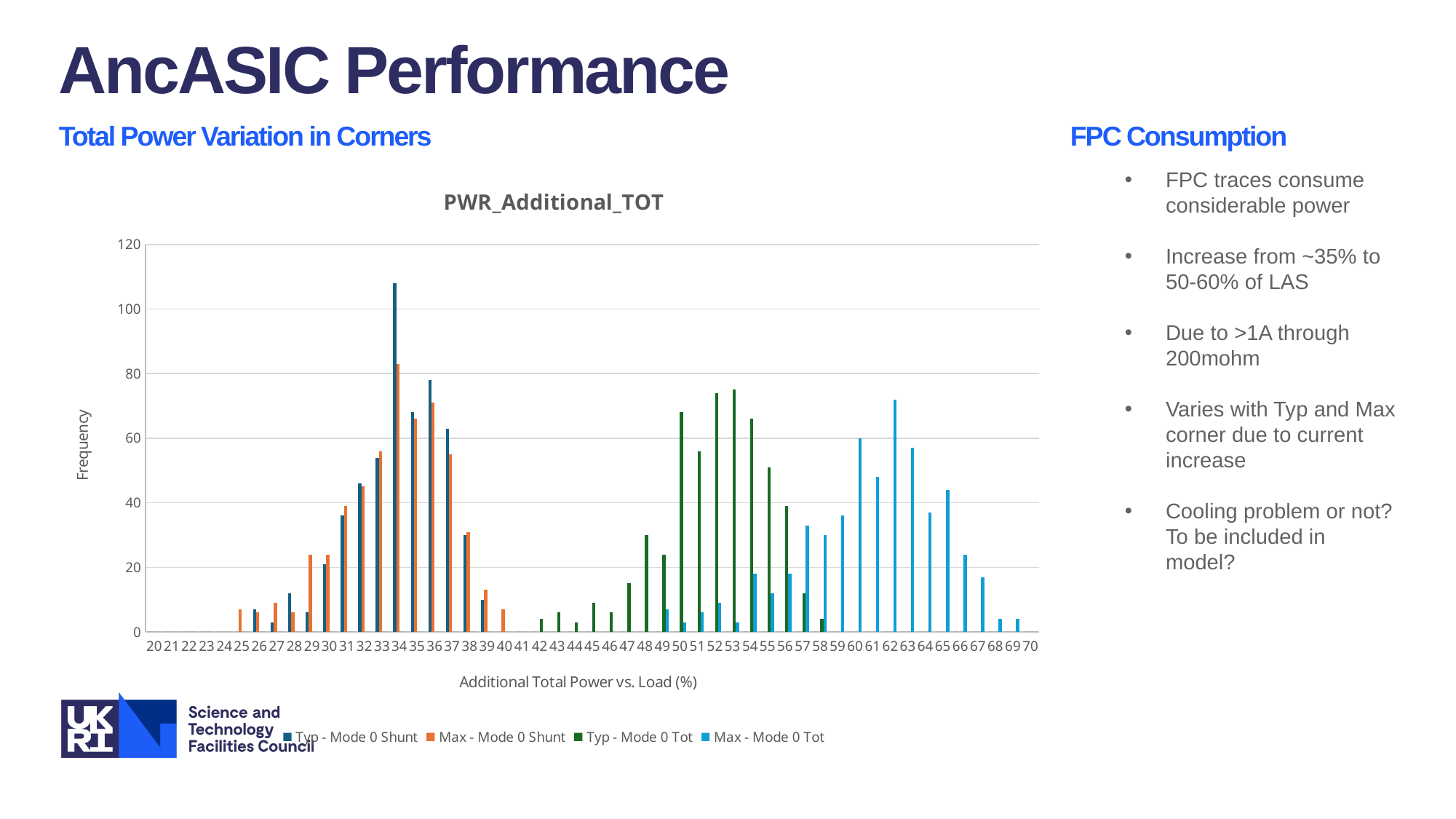
At x-axis value 34, which series has the higher frequency: Typ - Mode 0 Shunt or Max - Mode 0 Shunt? Typ - Mode 0 Shunt At which x-axis value does the Typ - Mode 0 Shunt series reach its highest frequency? 34 What kind of chart is shown on the slide? bar chart At which x-axis value does the Max - Mode 0 Shunt series reach its highest frequency? 34 How many series does the legend of the chart list? 4 What is the label of the x axis of the chart? Additional Total Power vs. Load (%) What is the title of the chart? PWR_Additional_TOT Which is larger: the peak frequency of Typ - Mode 0 Shunt (at 34) or the peak frequency of Max - Mode 0 Tot (at 62)? Typ - Mode 0 Shunt Is the frequency for Typ - Mode 0 Tot at 42 greater or less than 20? less Is the frequency for Typ - Mode 0 Shunt at 34 greater or less than 100? greater At which x-axis value does the Max - Mode 0 Tot series reach its highest frequency? 62 Is the frequency for Max - Mode 0 Tot at 62 greater or less than 60? greater